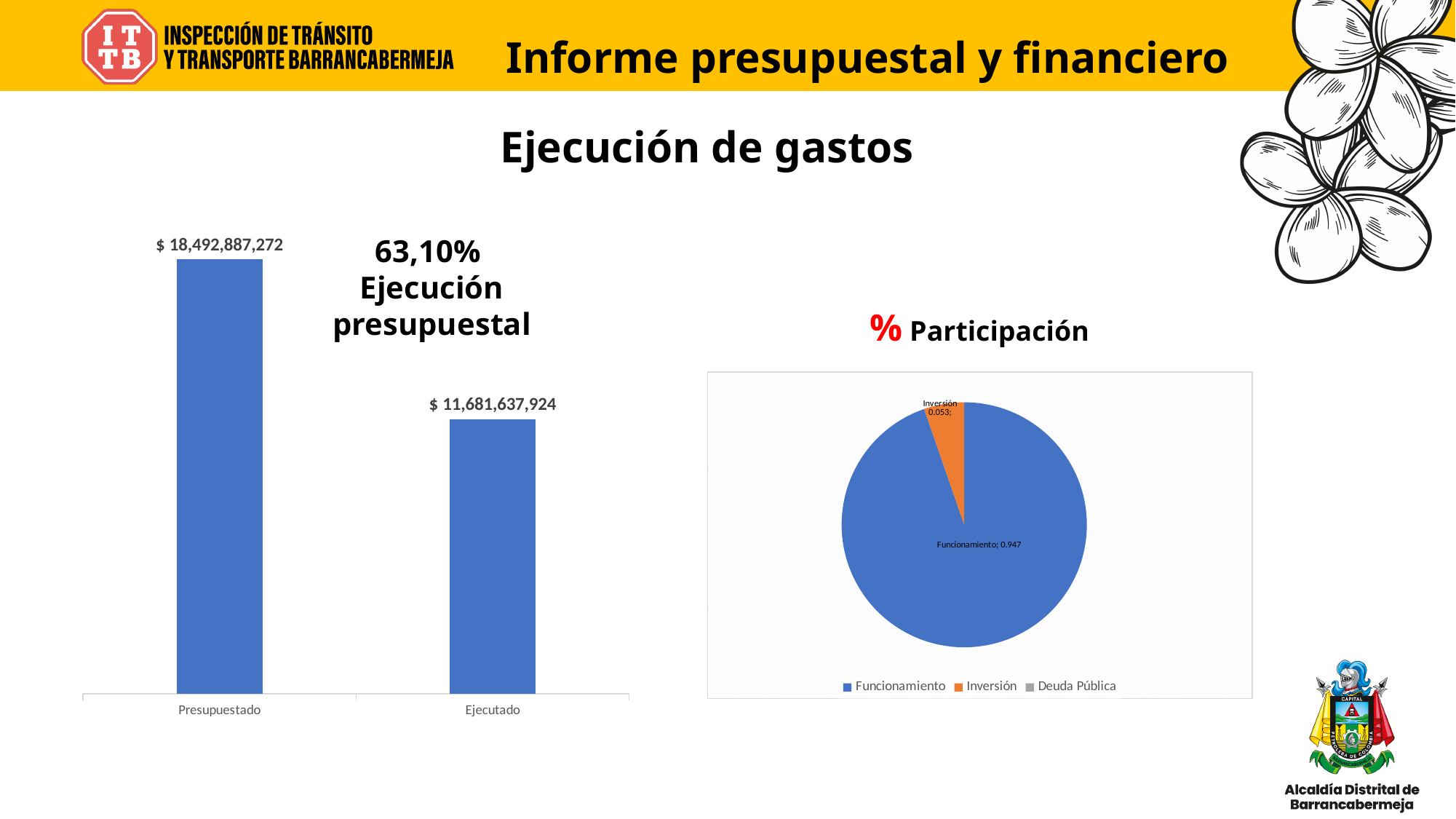
In the '% Participación' chart, what is the value shown for Funcionamiento? 0.947 What type of chart is the one on the left of the slide? Bar chart In the bar chart on the left, which category has the lower value? Ejecutado In the bar chart on the left, what is the value for Ejecutado? $ 11,681,637,924 In the bar chart on the left, which category has the higher value? Presupuestado How many entries does the legend of the '% Participación' chart list? 3 In the bar chart on the left, how many categories are shown on the x axis? 2 In the '% Participación' chart, what is the value shown for Inversión? 0.053 What type of chart is the '% Participación' chart? Pie chart In the bar chart on the left, what is the difference between the Presupuestado and Ejecutado values? $ 6,811,249,348 In the '% Participación' chart, which category has the largest slice? Funcionamiento In the bar chart on the left, what is the value for Presupuestado? $ 18,492,887,272